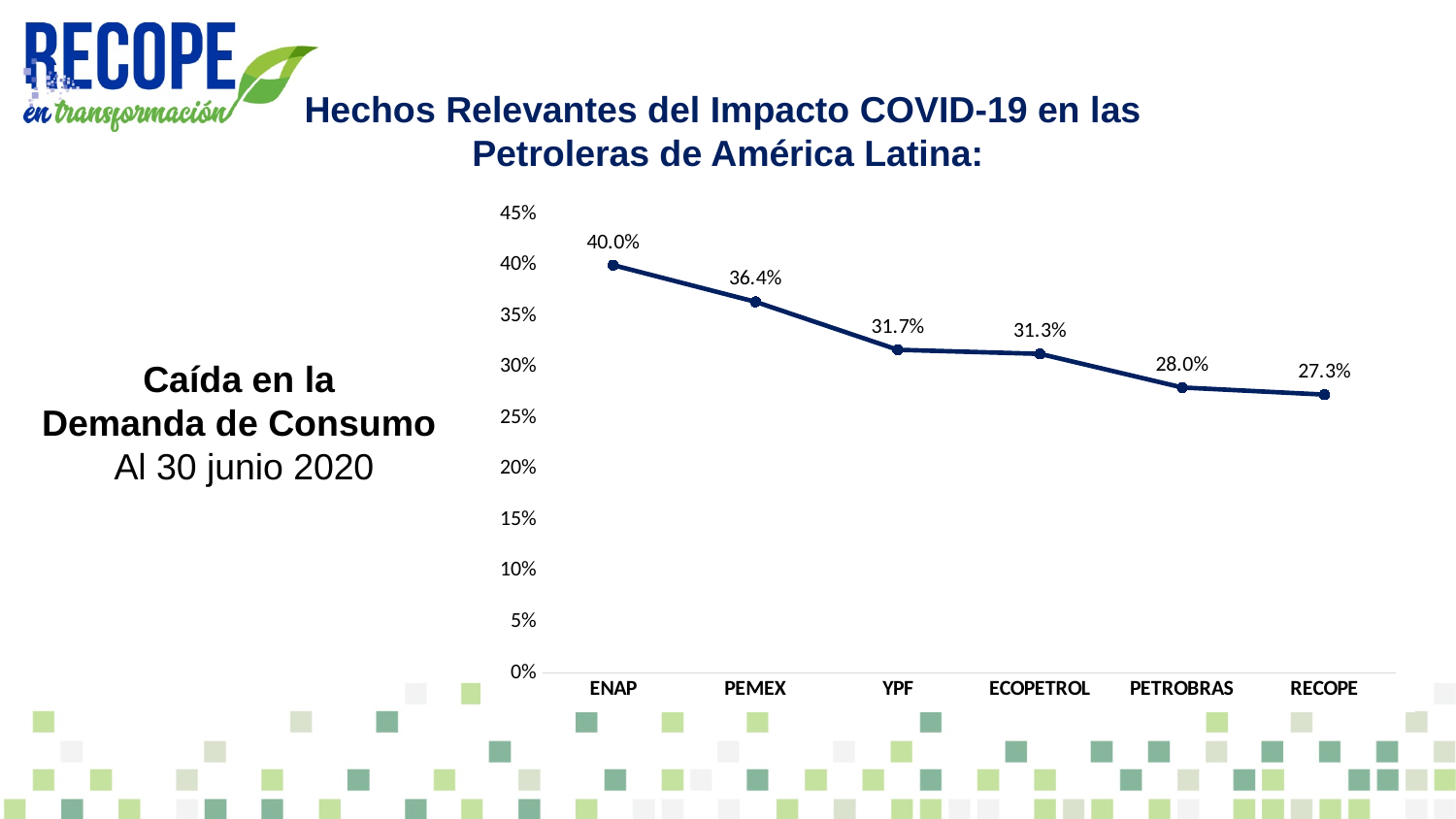
What is the difference between the values for YPF and ECOPETROL? 0.4% What is the difference between the values for ENAP and RECOPE? 12.7% Is the value for PETROBRAS greater or less than 30%? less How many companies are plotted on the chart? 6 Which company has the highest value? ENAP Do the values rise or fall from ENAP to RECOPE along the x axis? fall Which is larger, the value for PEMEX or the value for PETROBRAS? PEMEX What is the value for ENAP? 40.0% Which company has the lowest value? RECOPE What kind of chart is shown? line chart What is the value for RECOPE? 27.3% What is the value for PEMEX? 36.4%